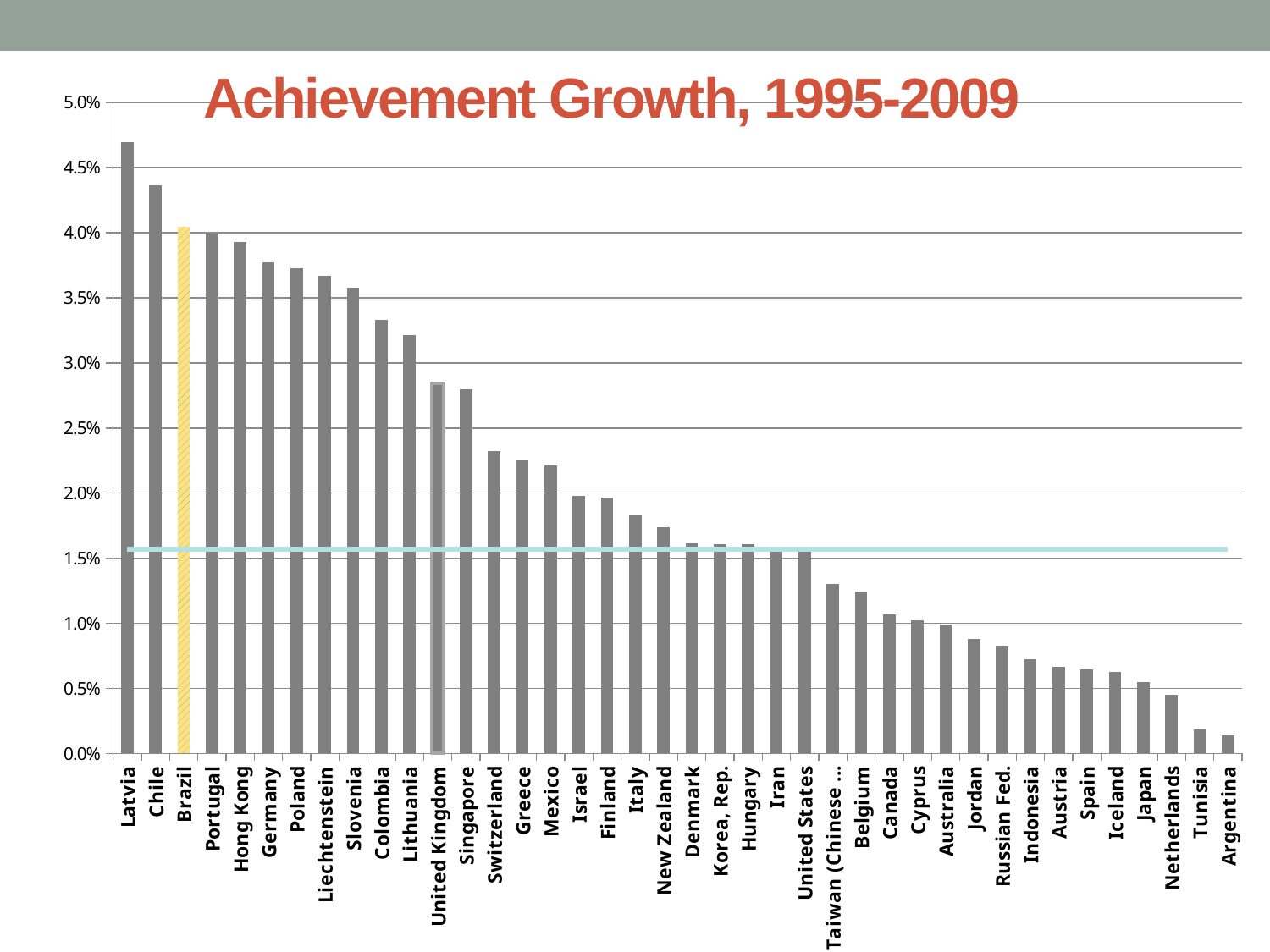
Do the values rise or fall moving from left to right along the x axis? fall Which has the larger value, Canada or Singapore? Singapore Which has the larger value, Chile or Portugal? Chile Which country has the highest achievement growth? Latvia Is the value for Japan greater or less than 1.0%? less Which country has the lowest achievement growth? Argentina How many countries are shown on the chart? 40 Is the value for Latvia greater or less than 4.5%? greater What is the title of the chart? Achievement Growth, 1995-2009 What kind of chart is shown on the slide? bar chart Is the value for United States greater or less than 2.0%? less